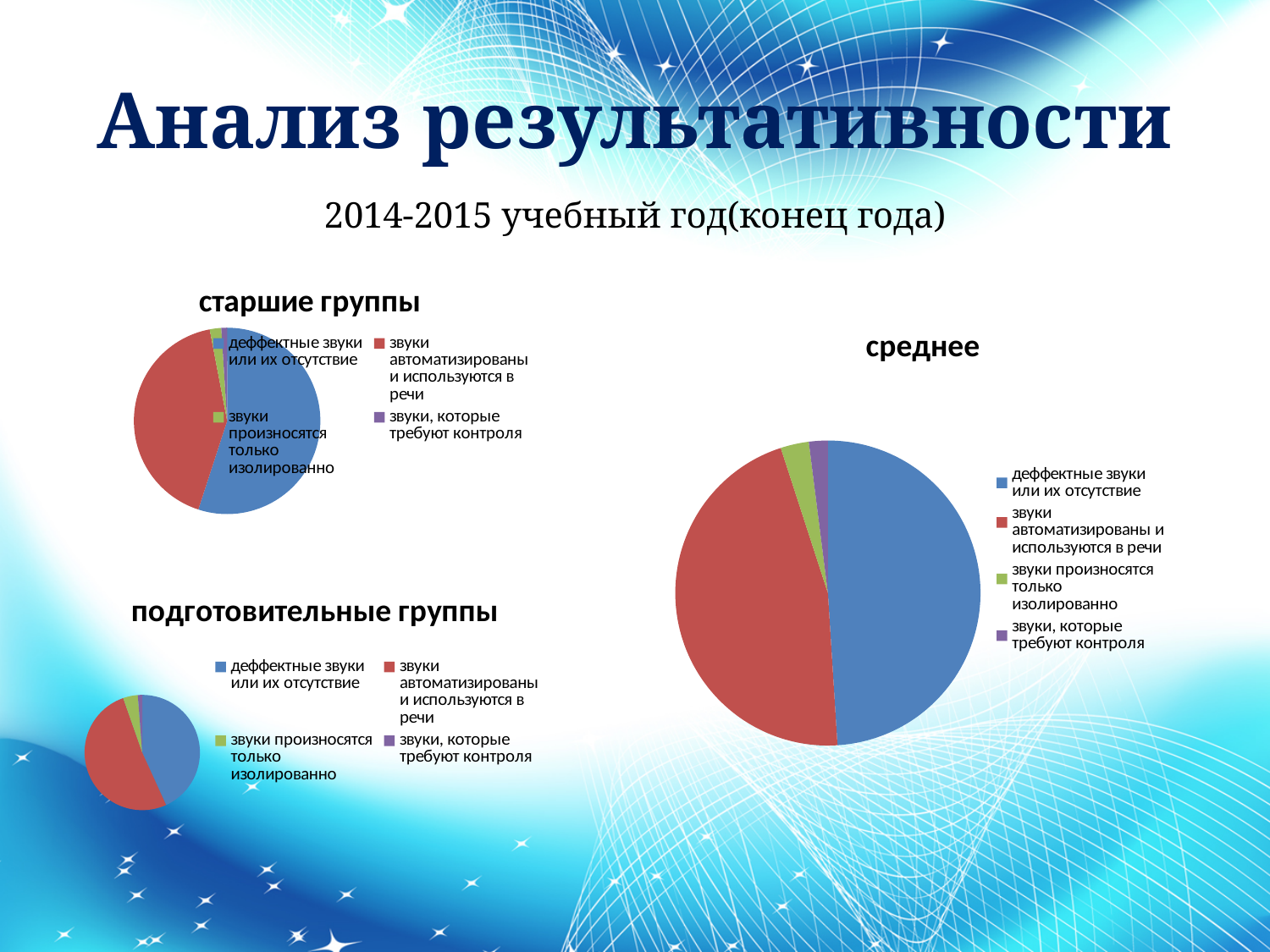
In the "среднее" chart, which category has the largest slice? деффектные звуки или их отсутствие In the "подготовительные группы" chart, which slice is larger: "деффектные звуки или их отсутствие" or "звуки произносятся только изолированно"? деффектные звуки или их отсутствие How many categories does the legend of the "подготовительные группы" chart list? 4 What kind of chart is the "старшие группы" chart? pie chart In the "среднее" chart, which category has the smallest slice? звуки, которые требуют контроля What colour represents "звуки, которые требуют контроля" in the "среднее" chart? purple In the "подготовительные группы" chart, which category has the largest slice? звуки автоматизированы и используются в речи What kind of chart is the "среднее" chart? pie chart In the "среднее" chart, which slice is larger: "звуки произносятся только изолированно" or "звуки, которые требуют контроля"? звуки произносятся только изолированно How many categories does the legend of the "среднее" chart list? 4 How many pie charts are shown on the slide? 3 In the "старшие группы" chart, which slice is larger: "звуки автоматизированы и используются в речи" or "звуки произносятся только изолированно"? звуки автоматизированы и используются в речи